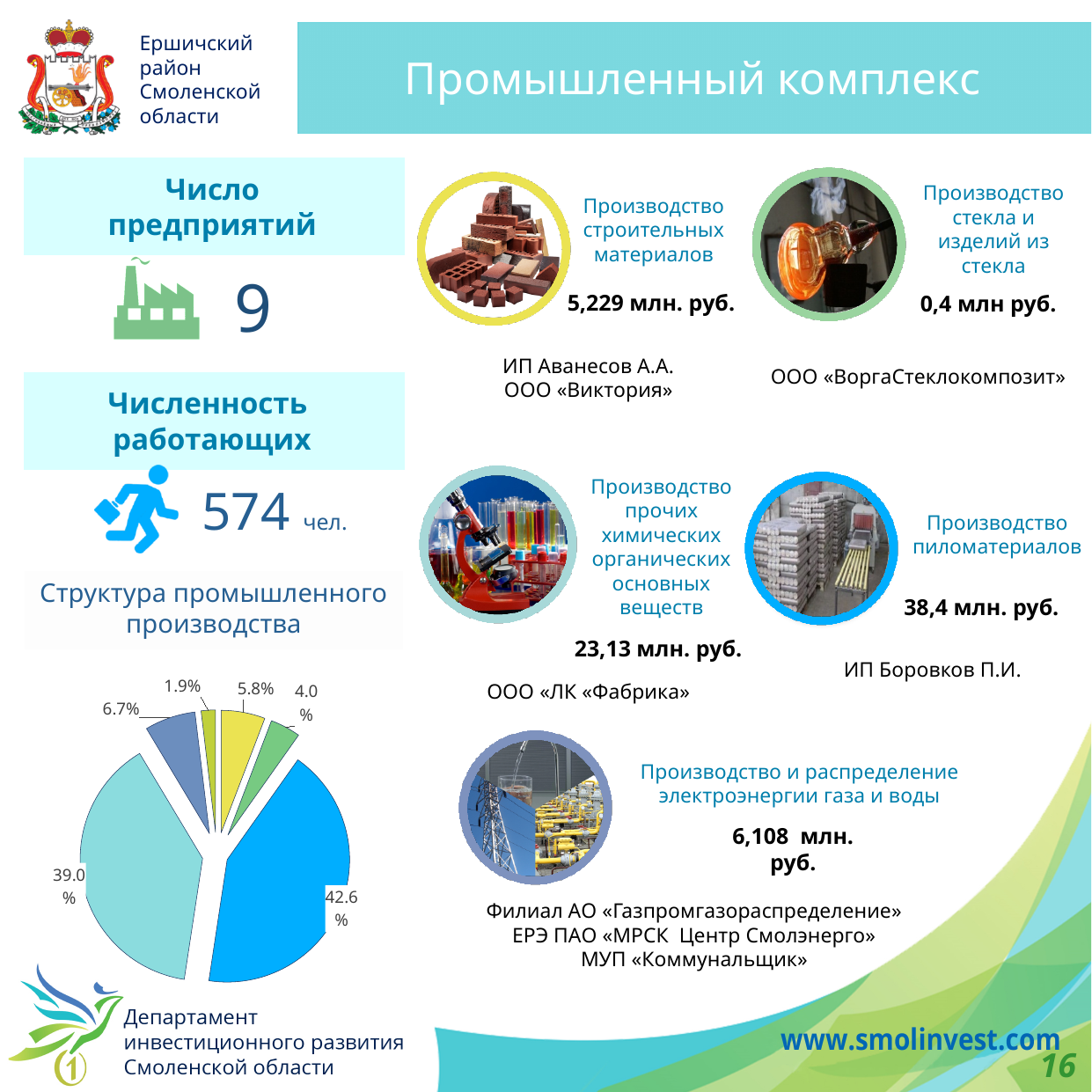
What share is labelled on the light turquoise slice of the pie chart «Структура промышленного производства»? 39.0% What share is labelled on the yellow slice of the pie chart «Структура промышленного производства»? 5.8% In the pie chart «Структура промышленного производства», which is larger: the slate-blue slice or the yellow slice? The slate-blue slice (6.7%) In the pie chart «Структура промышленного производства», what is the difference in percentage points between the two largest slices (42.6% and 39.0%)? 3.6 What share is labelled on the green slice of the pie chart «Структура промышленного производства»? 4.0% What is the share of the largest slice in the pie chart «Структура промышленного производства»? 42.6% What is the share of the smallest slice in the pie chart «Структура промышленного производства»? 1.9% What colour is the largest slice (42.6%) in the pie chart «Структура промышленного производства»? Blue Does the pie chart «Структура промышленного производства» have a legend? No How many slices in the pie chart «Структура промышленного производства» are labelled with a share below 10%? 4 How many slices does the pie chart «Структура промышленного производства» have? 6 What kind of chart is shown under the heading «Структура промышленного производства»? Pie chart